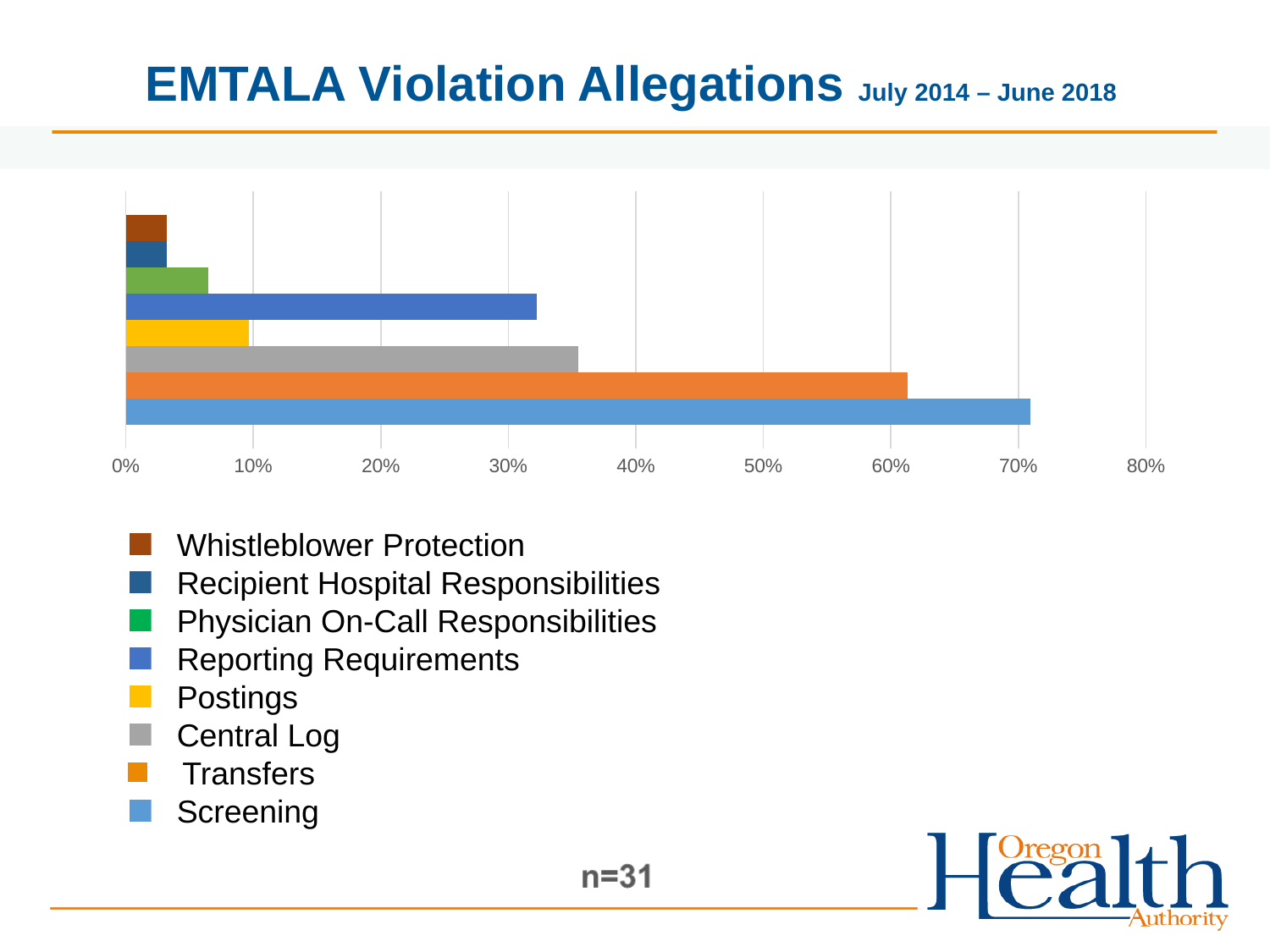
Which is larger, the value for Reporting Requirements or the value for Postings? Reporting Requirements Is the value for Transfers greater or less than 70%? less Is the value for Reporting Requirements greater or less than 40%? less Which category has the highest value? Screening How many entries does the legend list? 8 Is the value for Central Log greater or less than 30%? greater Which is larger, the value for Transfers or the value for Central Log? Transfers How many bars are plotted in the chart? 8 What kind of chart is shown on the slide? bar chart What sample size (n) is stated on the slide? n=31